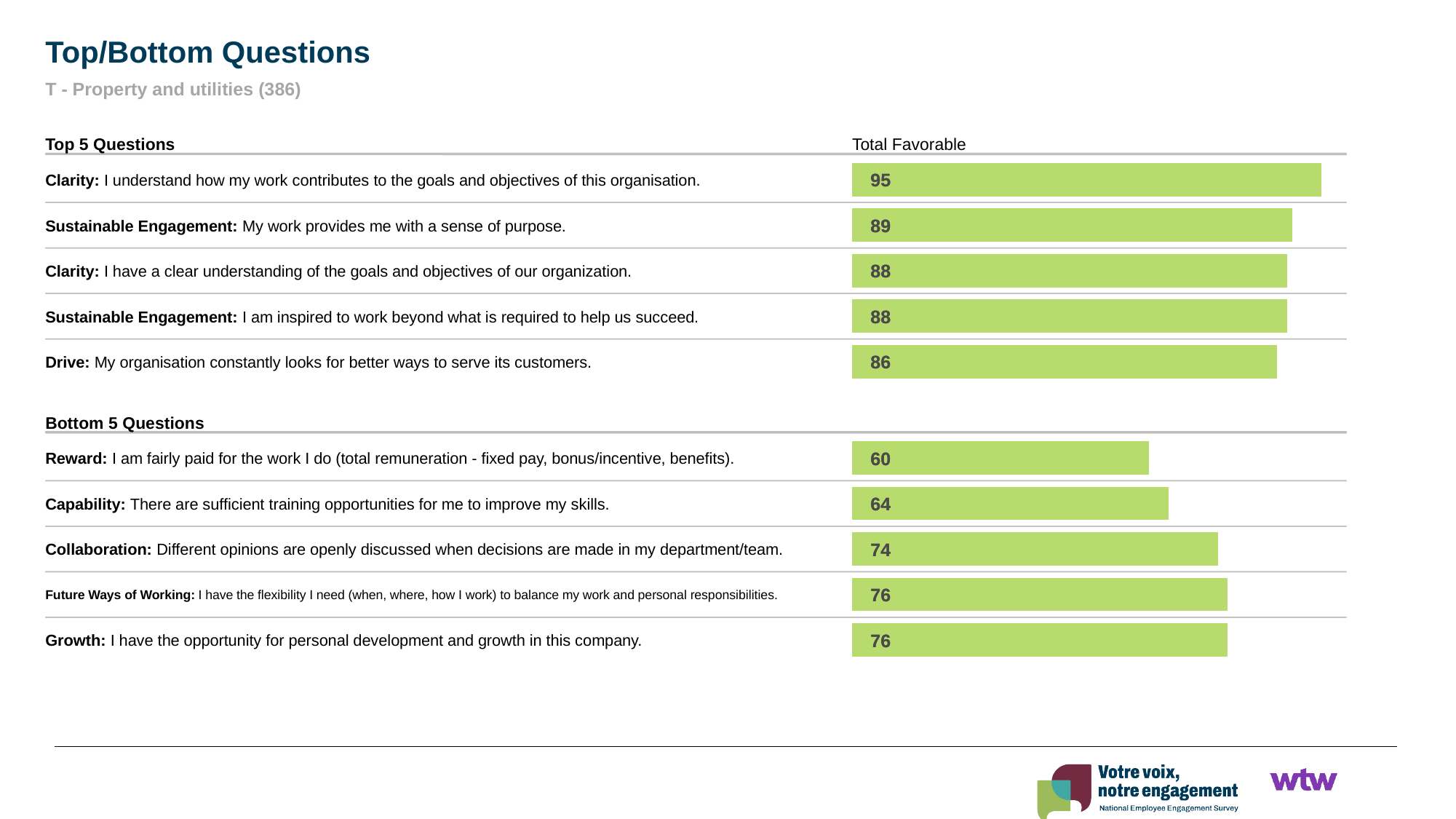
What is the column heading above the bars in the Top 5 Questions chart? Total Favorable In the Top 5 Questions chart, what is the difference between the Total Favorable values for "Clarity: I understand how my work contributes..." (95) and "Drive: My organisation constantly looks for better ways to serve its customers" (86)? 9 In the Bottom 5 Questions chart, what is the Total Favorable value for "Capability: There are sufficient training opportunities for me to improve my skills"? 64 In the Bottom 5 Questions chart, which question has the lowest Total Favorable value? Reward: I am fairly paid for the work I do (total remuneration - fixed pay, bonus/incentive, benefits). In the Top 5 Questions chart, what is the Total Favorable value for "Drive: My organisation constantly looks for better ways to serve its customers"? 86 In the Top 5 Questions chart, what is the Total Favorable value for "Clarity: I understand how my work contributes to the goals and objectives of this organisation"? 95 What kind of chart is used to show the Total Favorable values on this slide? Bar chart In the Bottom 5 Questions chart, what is the difference between the Total Favorable values for Collaboration (74) and Reward (60)? 14 How many questions are shown in the Bottom 5 Questions chart? 5 In the Bottom 5 Questions chart, what is the Total Favorable value for "Reward: I am fairly paid for the work I do"? 60 In the Bottom 5 Questions chart, which has a larger Total Favorable value: Capability or Collaboration? Collaboration In the Top 5 Questions chart, which question has the highest Total Favorable value? Clarity: I understand how my work contributes to the goals and objectives of this organisation.